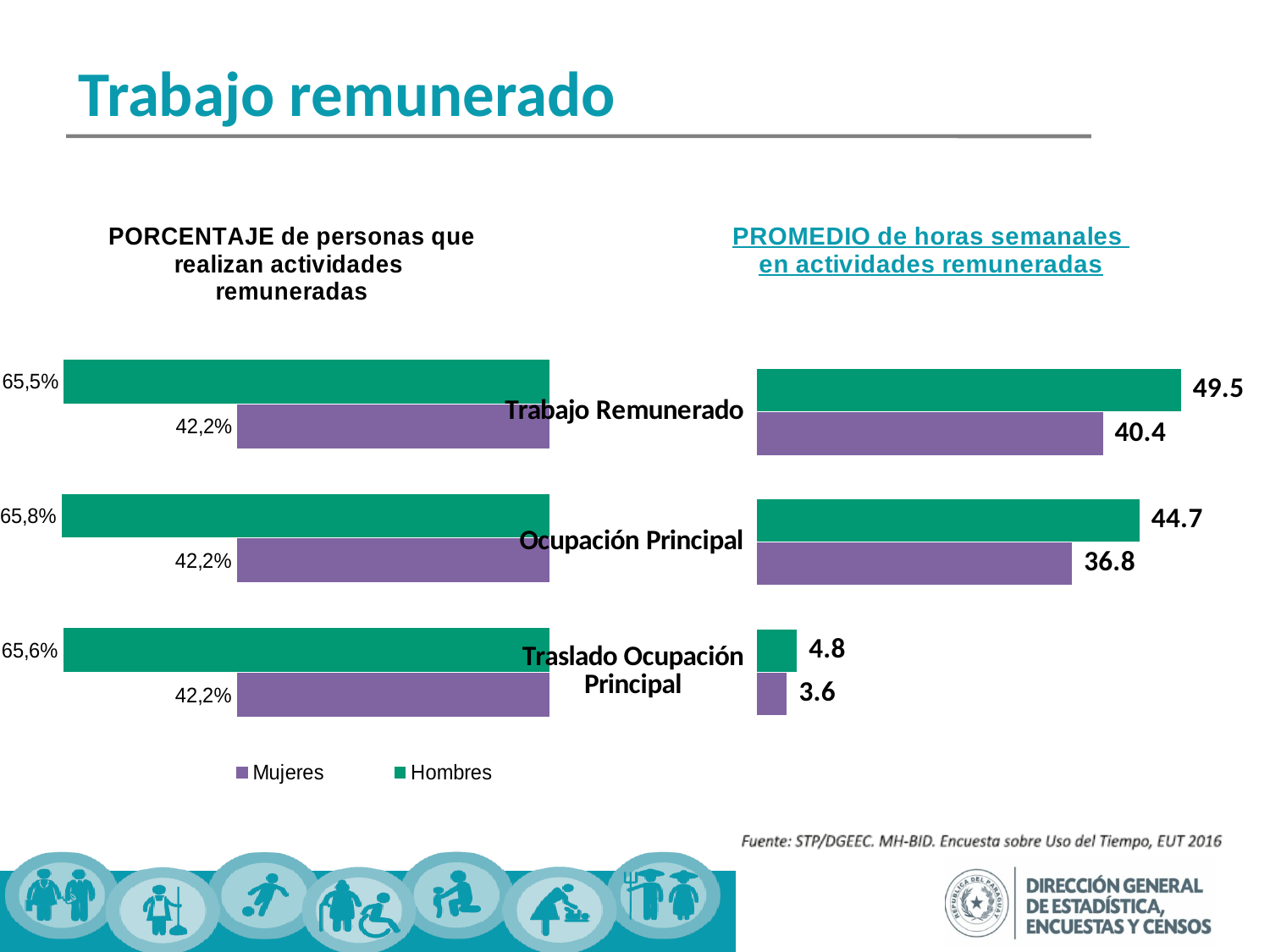
What kind of chart is 'PROMEDIO de horas semanales en actividades remuneradas'? Bar chart In the chart 'PROMEDIO de horas semanales en actividades remuneradas', what is the difference between Hombres and Mujeres in Traslado Ocupación Principal? 1.2 In the chart 'PORCENTAJE de personas que realizan actividades remuneradas', what is the value for Mujeres in Traslado Ocupación Principal? 42,2% How many series does the legend list for the chart 'PORCENTAJE de personas que realizan actividades remuneradas'? 2 In the chart 'PORCENTAJE de personas que realizan actividades remuneradas', what is the value for Hombres in Ocupación Principal? 65,8% In the chart 'PORCENTAJE de personas que realizan actividades remuneradas', which is larger in Trabajo Remunerado, Hombres or Mujeres? Hombres In the chart 'PROMEDIO de horas semanales en actividades remuneradas', what is the difference between Hombres and Mujeres in Trabajo Remunerado? 9.1 In the chart 'PROMEDIO de horas semanales en actividades remuneradas', which category has the lowest value for Hombres? Traslado Ocupación Principal In the chart 'PROMEDIO de horas semanales en actividades remuneradas', what is the value for Hombres in Trabajo Remunerado? 49.5 In the chart 'PROMEDIO de horas semanales en actividades remuneradas', which category has the highest value for Mujeres? Trabajo Remunerado In the chart 'PROMEDIO de horas semanales en actividades remuneradas', what is the value for Mujeres in Ocupación Principal? 36.8 How many categories are shown in the chart 'PROMEDIO de horas semanales en actividades remuneradas'? 3